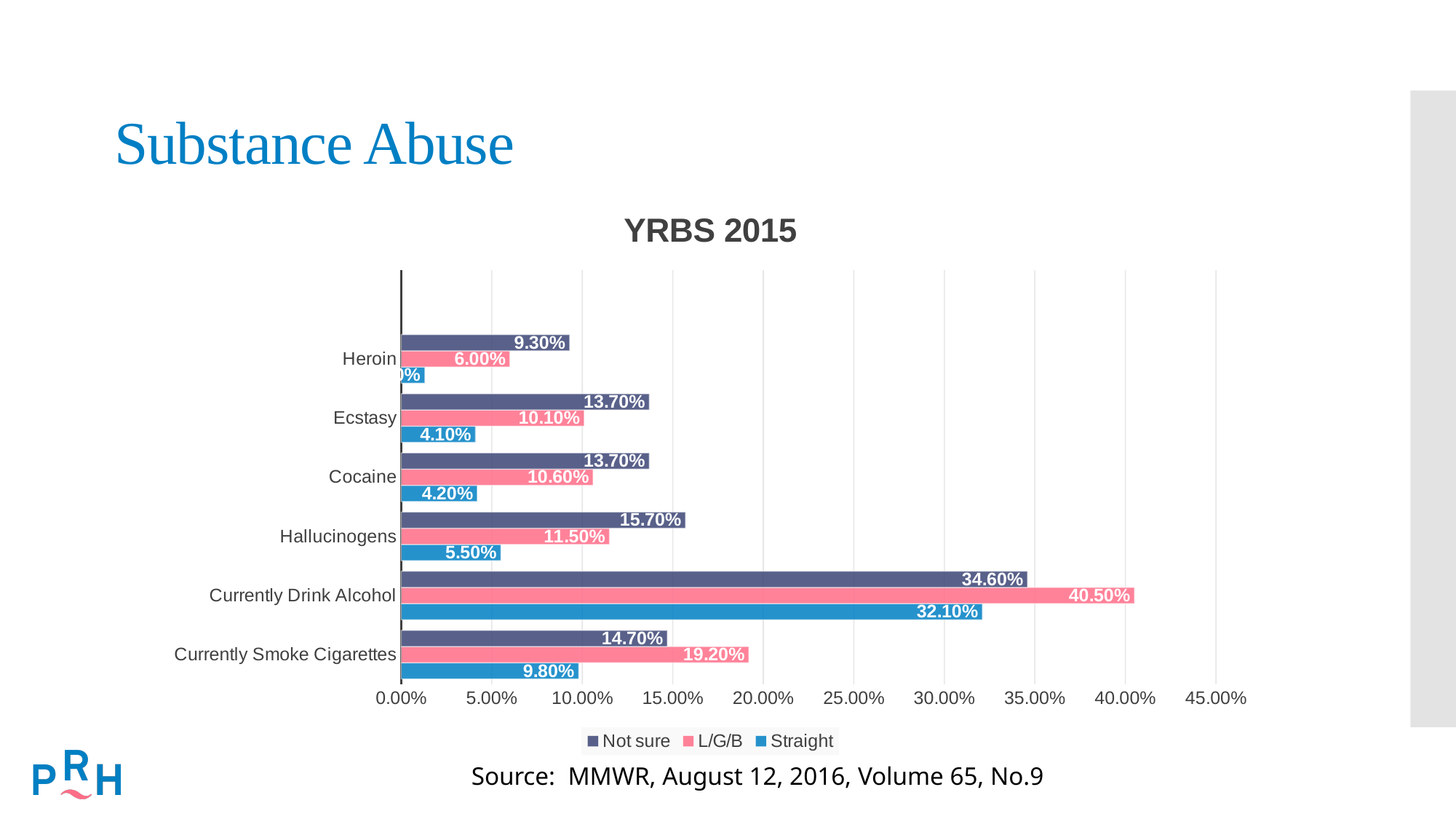
How many series does the legend list? 3 What is the Not sure value for Ecstasy? 13.70% What is the difference between the L/G/B and Straight values for Currently Smoke Cigarettes? 9.40% What type of chart is shown on the slide? Bar chart Which category has the highest L/G/B value? Currently Drink Alcohol How many categories are shown on the chart? 6 What is the title of the chart? YRBS 2015 What is the L/G/B value for Currently Drink Alcohol? 40.50% What is the Straight value for Hallucinogens? 5.50% Is the Straight value for Currently Drink Alcohol greater or less than 30.00%? greater Which is larger for Cocaine, the Not sure value or the L/G/B value? Not sure Which category has the lowest Not sure value? Heroin